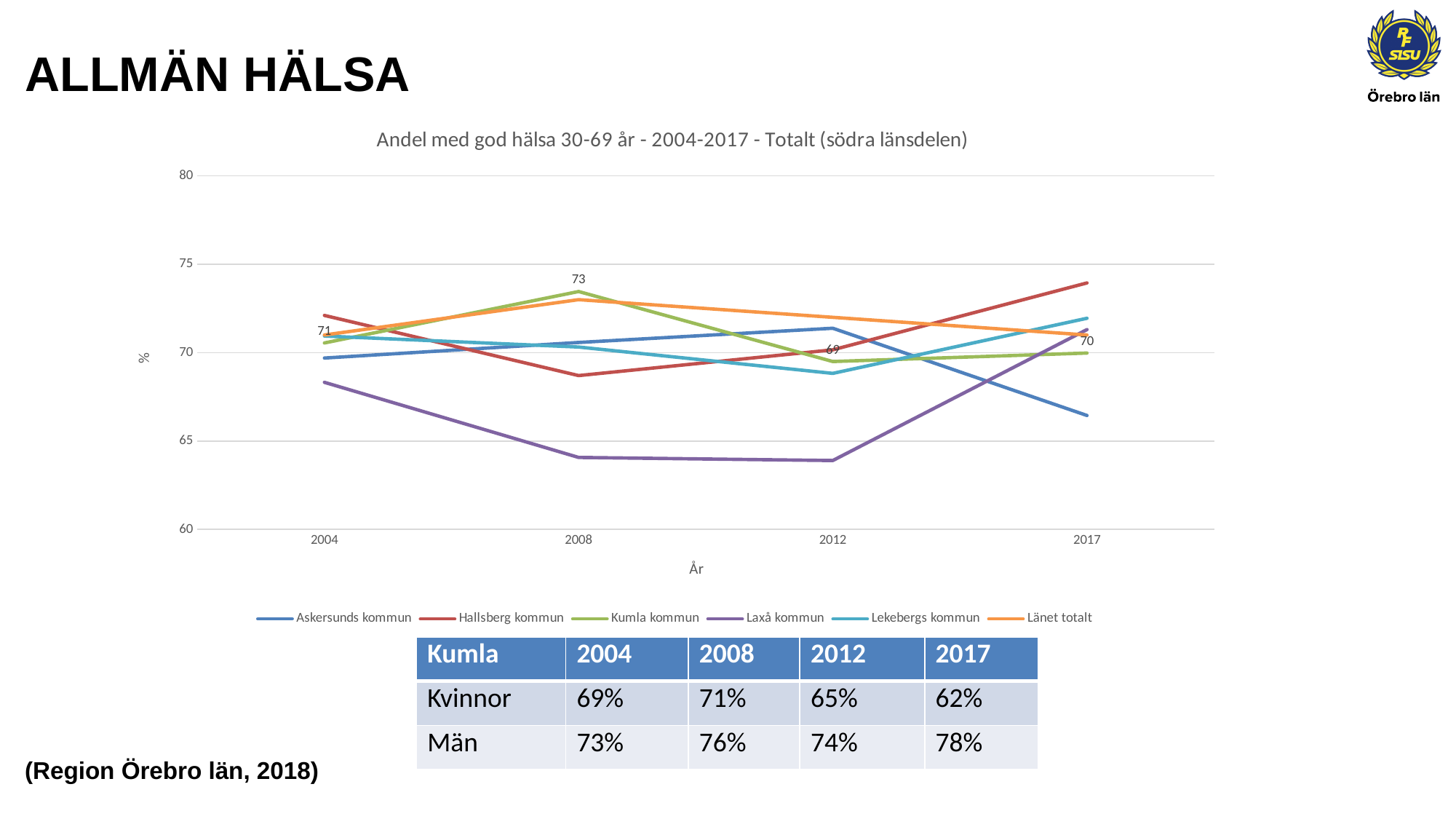
What is the value for Kumla kommun in 2017? 70 What is the title of the chart? Andel med god hälsa 30-69 år - 2004-2017 - Totalt (södra länsdelen) Which series has the highest value in 2017? Hallsberg kommun Is the value for Laxå kommun in 2012 greater or less than 65? less What kind of chart is shown on the slide? line chart How many series does the legend of the chart list? 6 How many years are shown on the x axis of the chart? 4 What is the value for Kumla kommun in 2012? 69 What is the difference between the Kumla kommun values for 2008 and 2012? 4 Which series has the lowest value in 2008? Laxå kommun What is the value for Kumla kommun in 2008? 73 Which is larger in 2017, the value for Hallsberg kommun or the value for Askersunds kommun? Hallsberg kommun